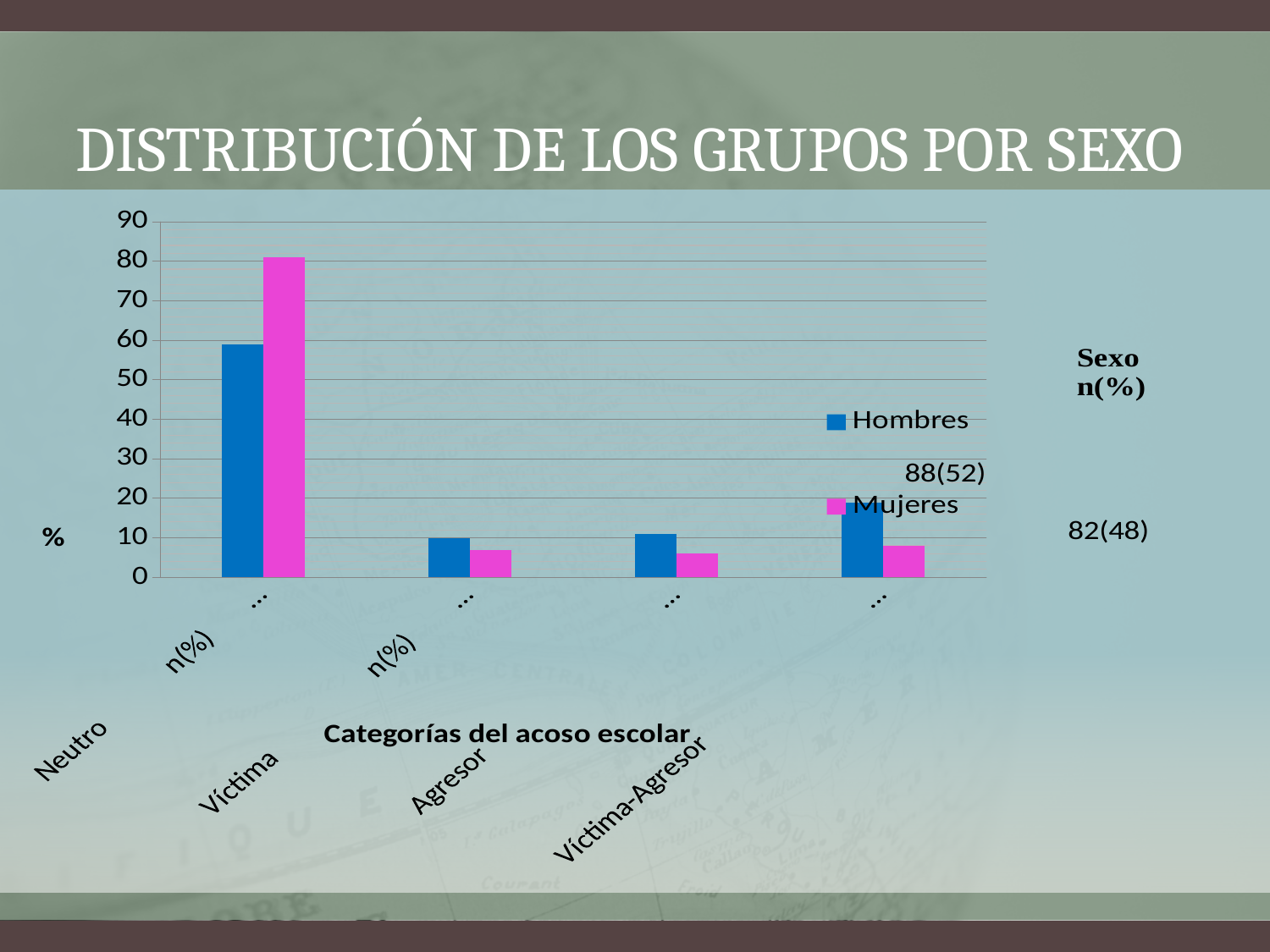
How many series does the legend list? 2 What kind of chart is shown on the slide? bar chart Is the Hombres value for Neutro greater or less than 50? greater For the Neutro category, which is larger: Hombres or Mujeres? Mujeres What is the title of the x axis? Categorías del acoso escolar Which category has the highest value for Mujeres? Neutro For the Víctima-Agresor category, which is larger: Hombres or Mujeres? Hombres Is the Mujeres value for Víctima greater or less than 10? less Which category has the highest value for Hombres? Neutro What are the two series named in the legend? Hombres and Mujeres How many categories of acoso escolar are plotted on the x axis? 4 Is the Mujeres value for Neutro greater or less than 70? greater